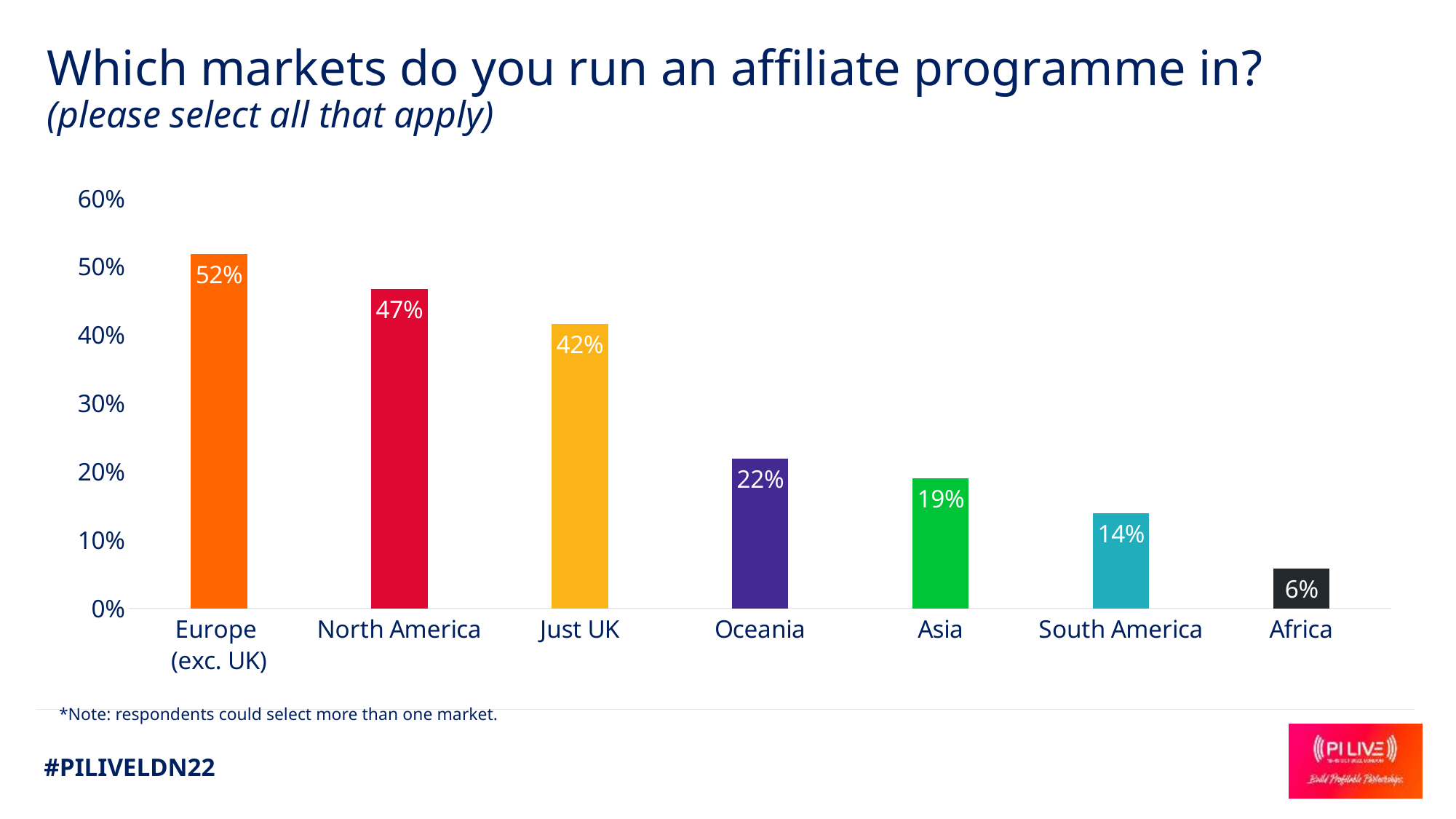
Do the values rise or fall from left to right across the markets? Fall What is the value shown for Oceania? 22% Which market has the lowest percentage? Africa What percentage of respondents run an affiliate programme in North America? 47% What kind of chart is shown on the slide? Bar chart Which is larger, the value for Oceania or the value for Asia? Oceania What is the difference between the values for Asia and Africa? 13% Is the value for Just UK greater or less than 40%? greater What is the difference between the values for Europe (exc. UK) and Just UK? 10% How many markets are shown on the chart? 7 Which market has the highest percentage? Europe (exc. UK) What percentage is shown for South America? 14%